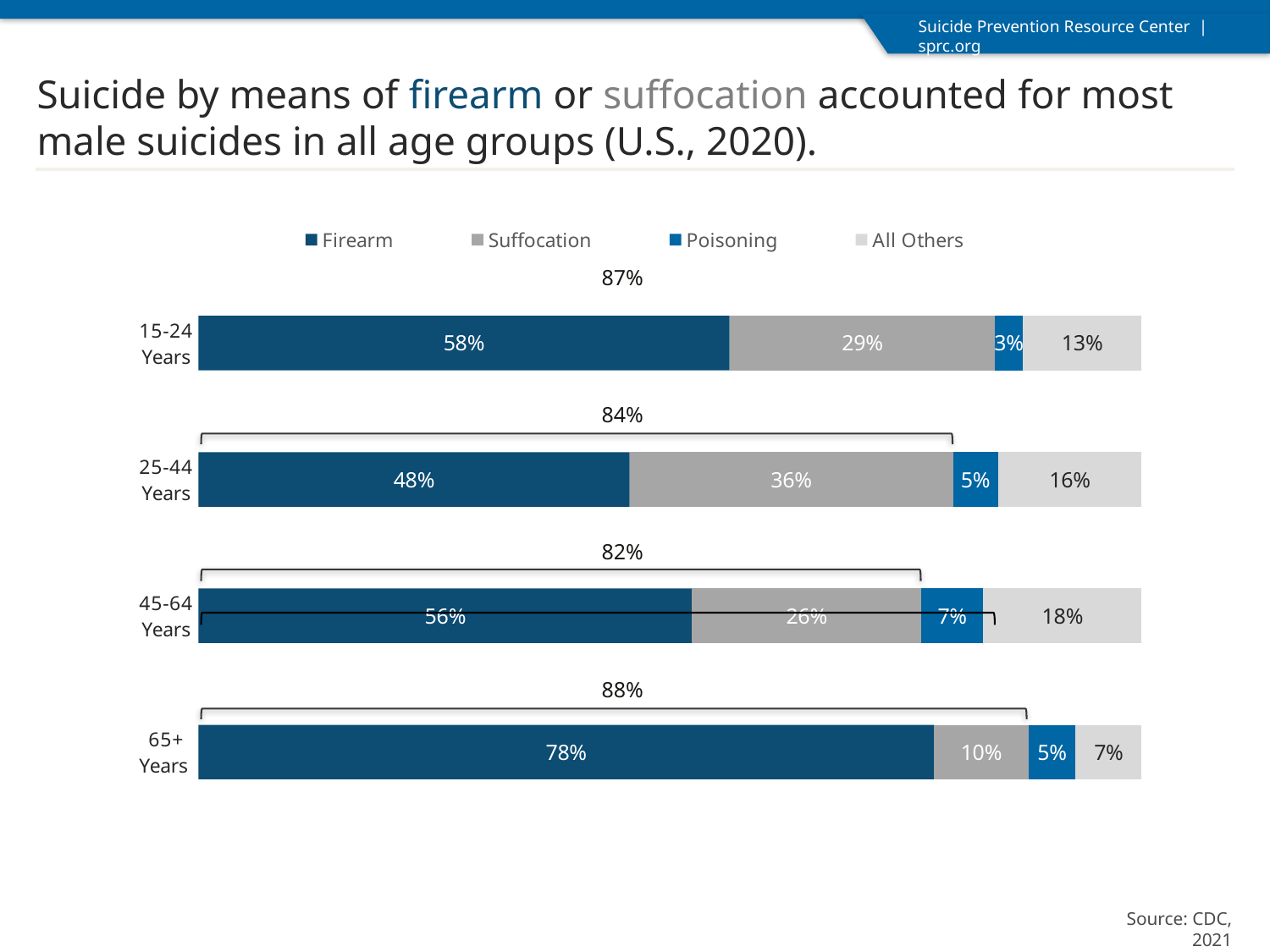
What combined Firearm and Suffocation percentage is shown above the 45-64 Years bar? 82% What is the Suffocation value for the 25-44 Years age group? 36% What is the difference between the Firearm values for the 15-24 Years and 25-44 Years age groups? 10% What kind of chart is shown on the slide? Stacked bar chart What is the All Others value for the 45-64 Years age group? 18% How many series does the legend list? 4 What is the Firearm value for the 65+ Years age group? 78% Which is larger, the Poisoning value for 45-64 Years or the Poisoning value for 25-44 Years? 45-64 Years What is the Poisoning value for the 15-24 Years age group? 3% How many age groups are plotted in the chart? 4 Which age group has the highest Firearm percentage? 65+ Years Which age group has the lowest Suffocation percentage? 65+ Years